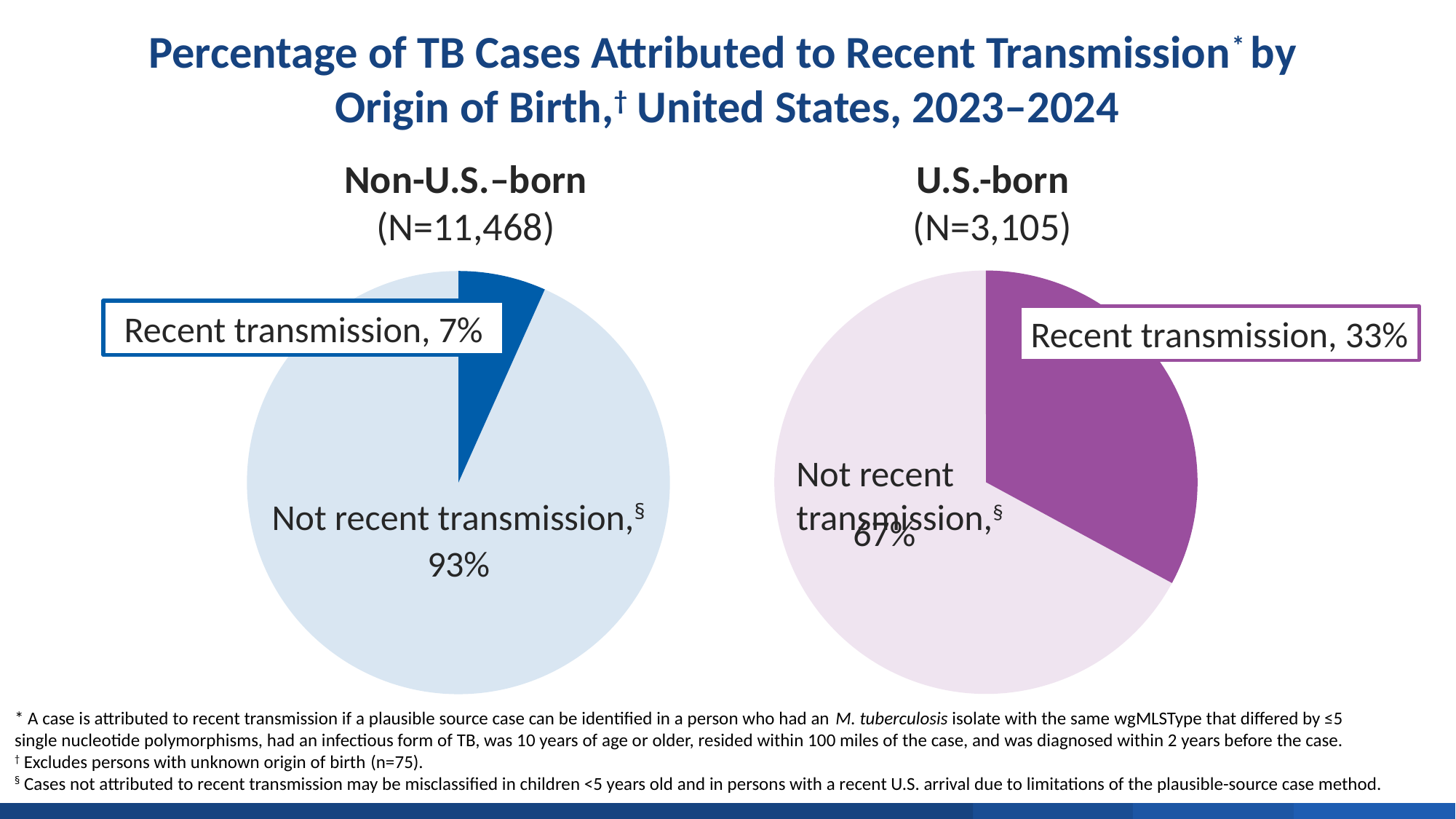
What is the N value shown for the Non-U.S.-born pie chart? N=11,468 In the Non-U.S.-born pie chart, which slice is the largest? Not recent transmission What is the difference in the recent transmission percentage between the U.S.-born and Non-U.S.-born pie charts? 26 percentage points Which group has the larger share of cases attributed to recent transmission, Non-U.S.-born or U.S.-born? U.S.-born In the Non-U.S.-born pie chart, what percentage of cases is not recent transmission? 93% In the U.S.-born pie chart, what percentage of cases is not recent transmission? 67% How many slices does the U.S.-born pie chart have? 2 What type of chart is used on this slide? Pie chart In the U.S.-born pie chart, what percentage of TB cases is attributed to recent transmission? 33% In the Non-U.S.-born pie chart, what percentage of TB cases is attributed to recent transmission? 7% How many pie charts are shown on the slide? 2 What is the N value shown for the U.S.-born pie chart? N=3,105